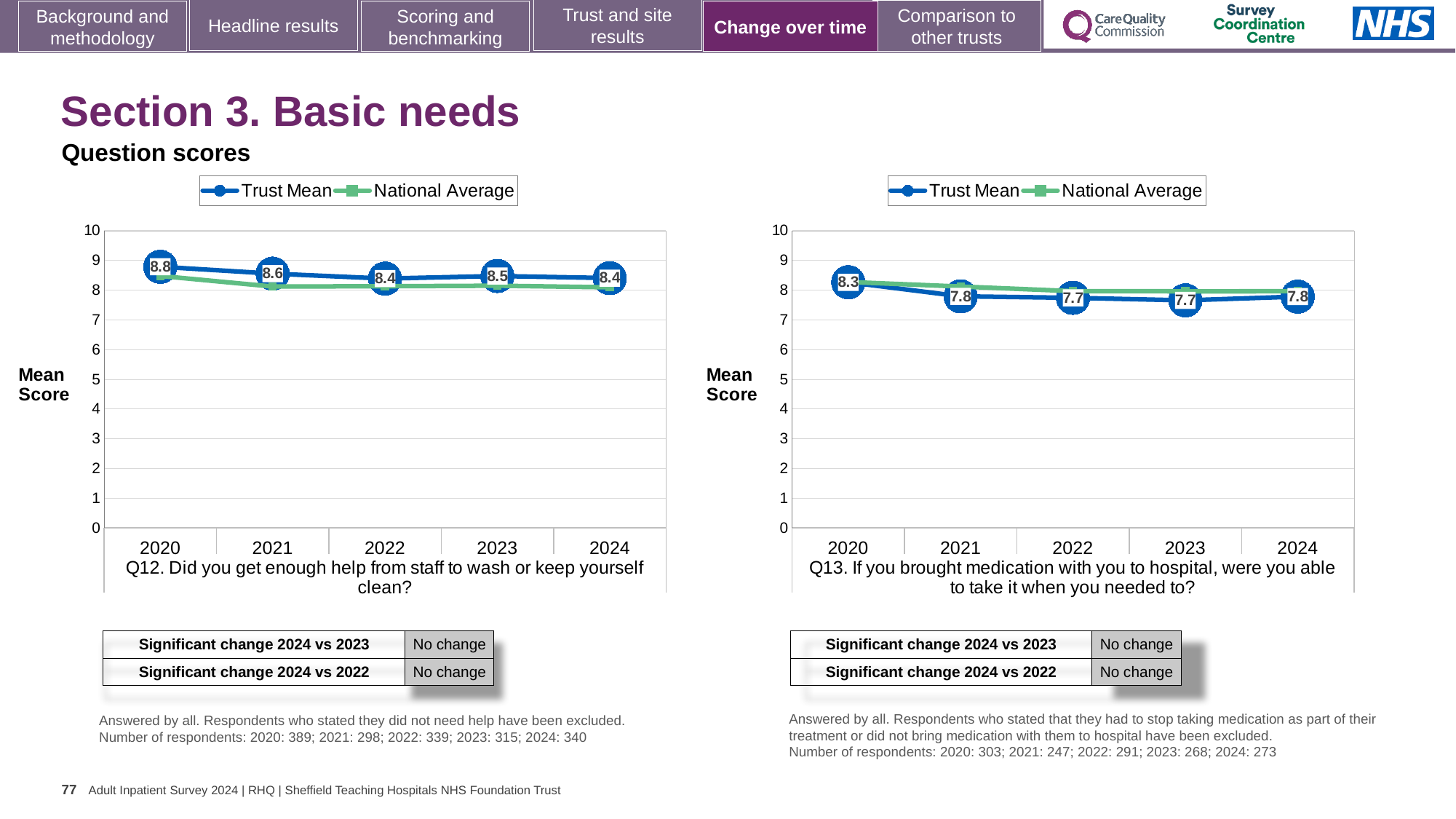
In the Q13 chart (right), is the Trust Mean score for 2022 greater or less than 8? less In the Q12 chart (left), what is the Trust Mean score for 2024? 8.4 In the Q13 chart (right), which year has the highest Trust Mean score? 2020 In the Q12 chart (left), what is the Trust Mean score for 2020? 8.8 In the Q12 chart (left), what is the difference between the Trust Mean scores for 2020 and 2024? 0.4 In the Q13 chart (right), is the Trust Mean score for 2020 greater or less than the Trust Mean score for 2021? greater In the Q13 chart (right), how many years are plotted on the x axis? 5 In the Q12 chart (left), how many series does the legend list? 2 In the Q12 chart (left), which year has the highest Trust Mean score? 2020 In the Q13 chart (right), what is the Trust Mean score for 2020? 8.3 What type of chart is used for the Q12 chart (left)? Line chart In the Q13 chart (right), what is the Trust Mean score for 2023? 7.7